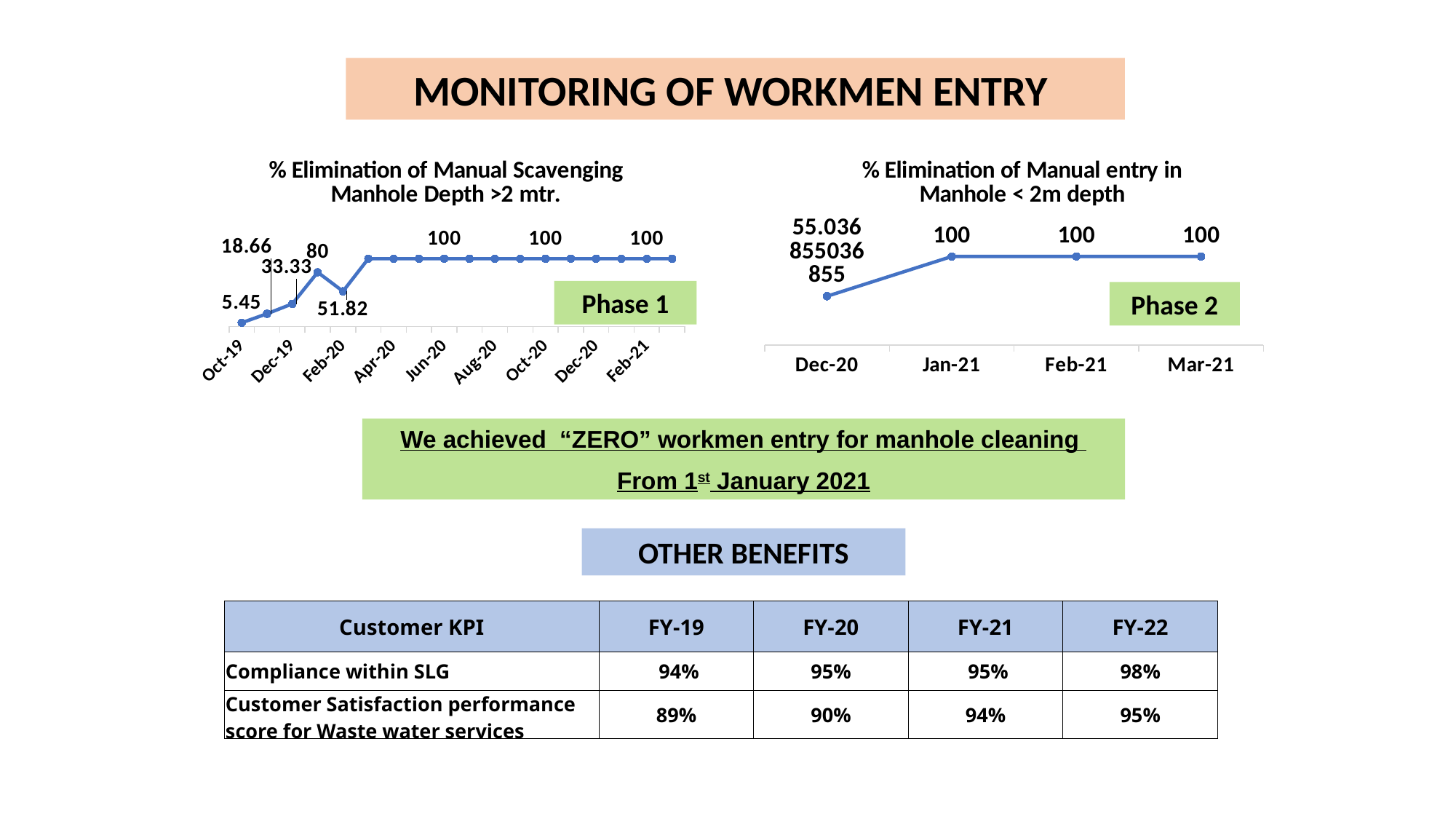
What type of chart is the '% Elimination of Manual entry in Manhole < 2m depth' chart? line chart In the '% Elimination of Manual Scavenging Manhole Depth >2 mtr.' chart, which is larger: the value for Dec-19 or the value for Feb-20? Feb-20 In the '% Elimination of Manual Scavenging Manhole Depth >2 mtr.' chart, which month has the lowest value? Oct-19 In the '% Elimination of Manual entry in Manhole < 2m depth' chart, which month has the lowest value? Dec-20 In the '% Elimination of Manual entry in Manhole < 2m depth' chart, do the values rise or fall from Dec-20 to Jan-21? rise In the '% Elimination of Manual Scavenging Manhole Depth >2 mtr.' chart, what is the value for Dec-19? 33.33 In the '% Elimination of Manual entry in Manhole < 2m depth' chart, what is the value for Jan-21? 100 In the '% Elimination of Manual Scavenging Manhole Depth >2 mtr.' chart, what is the value for Oct-19? 5.45 In the '% Elimination of Manual Scavenging Manhole Depth >2 mtr.' chart, what is the value for Feb-20? 51.82 What type of chart is the '% Elimination of Manual Scavenging Manhole Depth >2 mtr.' chart? line chart In the '% Elimination of Manual Scavenging Manhole Depth >2 mtr.' chart, what is the difference between the peak value of 80 and the following value of 51.82? 28.18 How many data points are plotted in the '% Elimination of Manual entry in Manhole < 2m depth' chart? 4